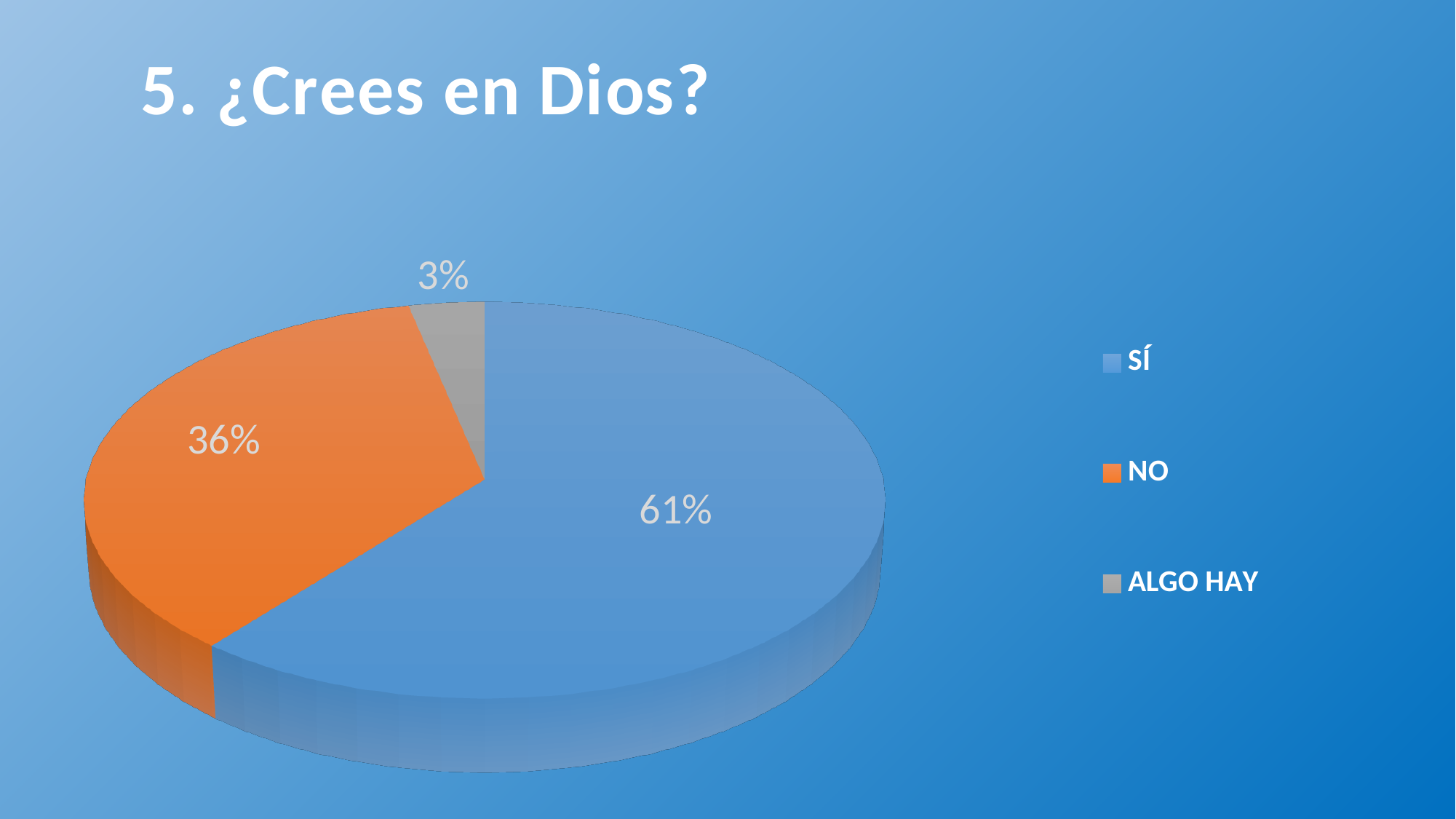
How many categories does the pie chart show? 3 What is the title of the slide? 5. ¿Crees en Dios? What is the difference in percentage points between NO and ALGO HAY? 33 Which category has the smallest slice of the pie? ALGO HAY What colour is the slice for NO? orange What share of the pie does SÍ represent? 61% What share of the pie does ALGO HAY represent? 3% Which category has the largest slice of the pie? SÍ What kind of chart is shown on the slide? pie chart Which is larger, the share for NO or the share for ALGO HAY? NO What share of the pie does NO represent? 36% What is the difference in percentage points between SÍ and NO? 25